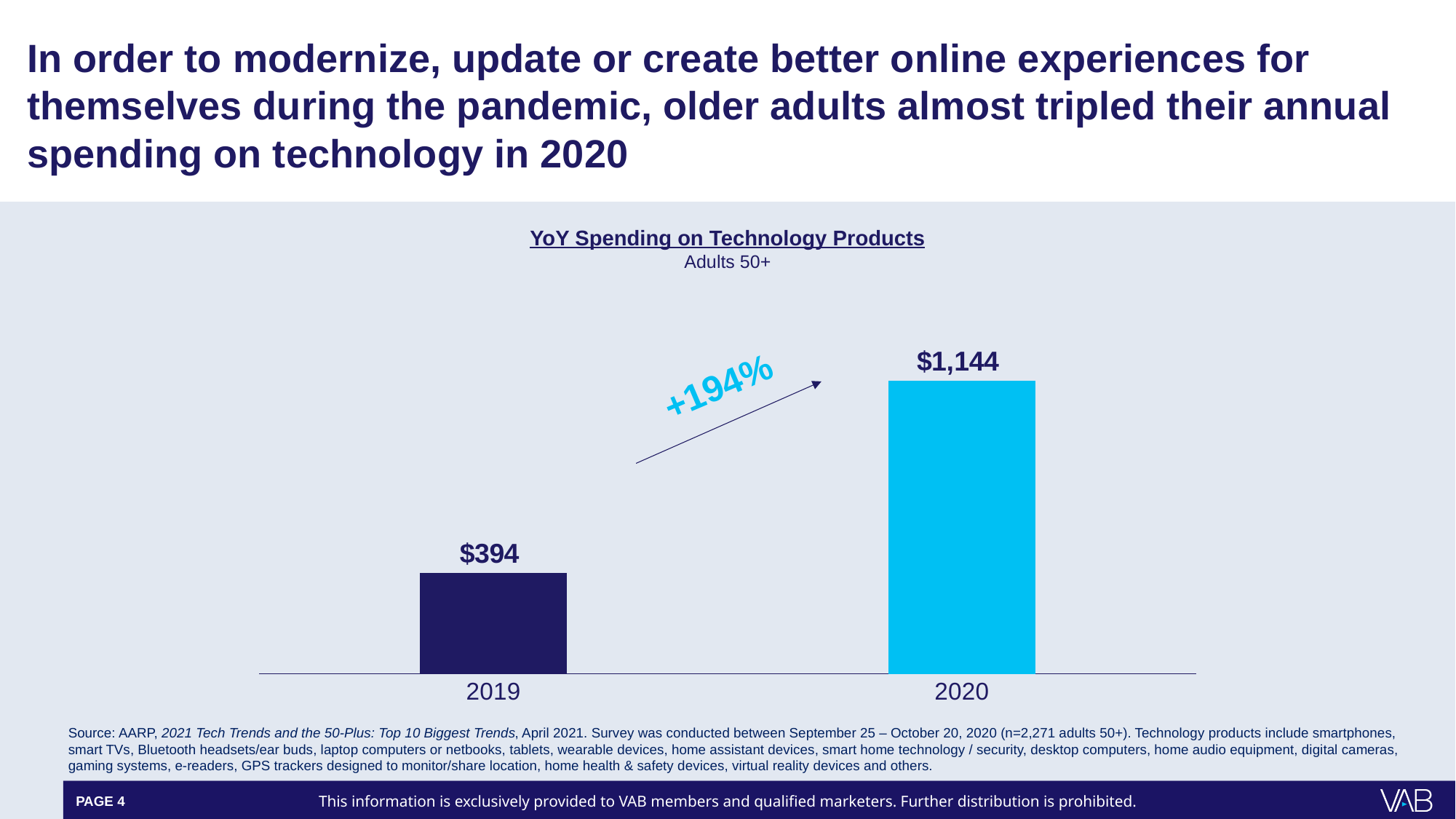
What is the value for 2019? $394 Which year has the lowest spending? 2019 Do the values rise or fall from 2019 to 2020? Rise What is the value for 2020? $1,144 What percentage change is annotated on the chart between 2019 and 2020? +194% How many years are shown on the chart? 2 What is the title of the chart? YoY Spending on Technology Products Which is larger, the value for 2019 or the value for 2020? 2020 Which year has the highest spending? 2020 What kind of chart is this? Bar chart What is the difference between the 2020 and 2019 values? $750